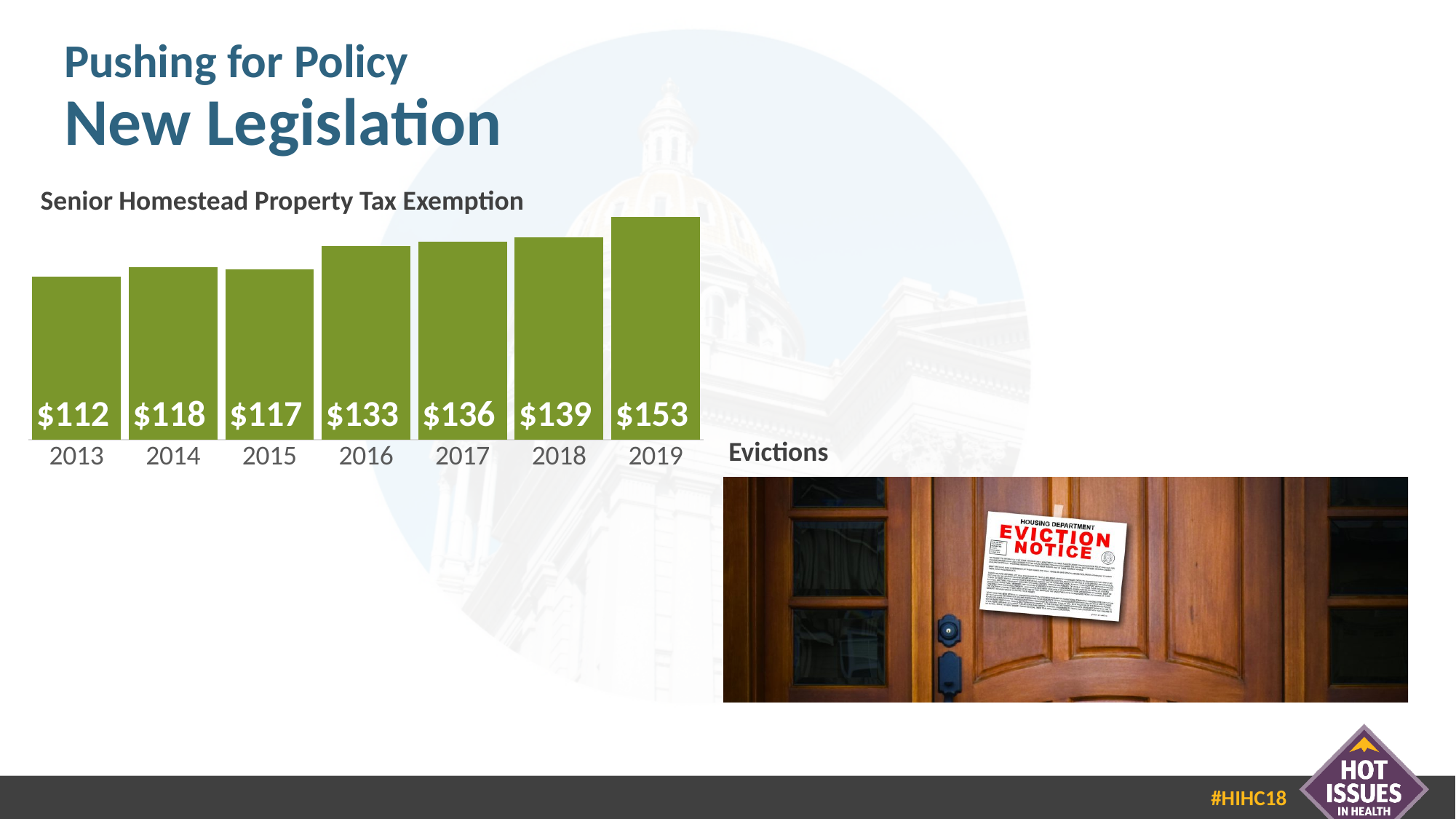
What is the value for 2016 in the Senior Homestead Property Tax Exemption chart? $133 What is the difference between the 2016 and 2015 values in the Senior Homestead Property Tax Exemption chart? $16 Which year has the lowest value in the Senior Homestead Property Tax Exemption chart? 2013 Which is larger in the Senior Homestead Property Tax Exemption chart, the value for 2014 or the value for 2015? 2014 What kind of chart is the Senior Homestead Property Tax Exemption chart? Bar chart What is the difference between the 2019 and 2013 values in the Senior Homestead Property Tax Exemption chart? $41 Which year has the highest value in the Senior Homestead Property Tax Exemption chart? 2019 What is the value for 2019 in the Senior Homestead Property Tax Exemption chart? $153 Do the values in the Senior Homestead Property Tax Exemption chart generally rise or fall from 2013 to 2019? Rise What is the value for 2013 in the Senior Homestead Property Tax Exemption chart? $112 What colour are the bars in the Senior Homestead Property Tax Exemption chart? Green How many years are shown in the Senior Homestead Property Tax Exemption chart? 7